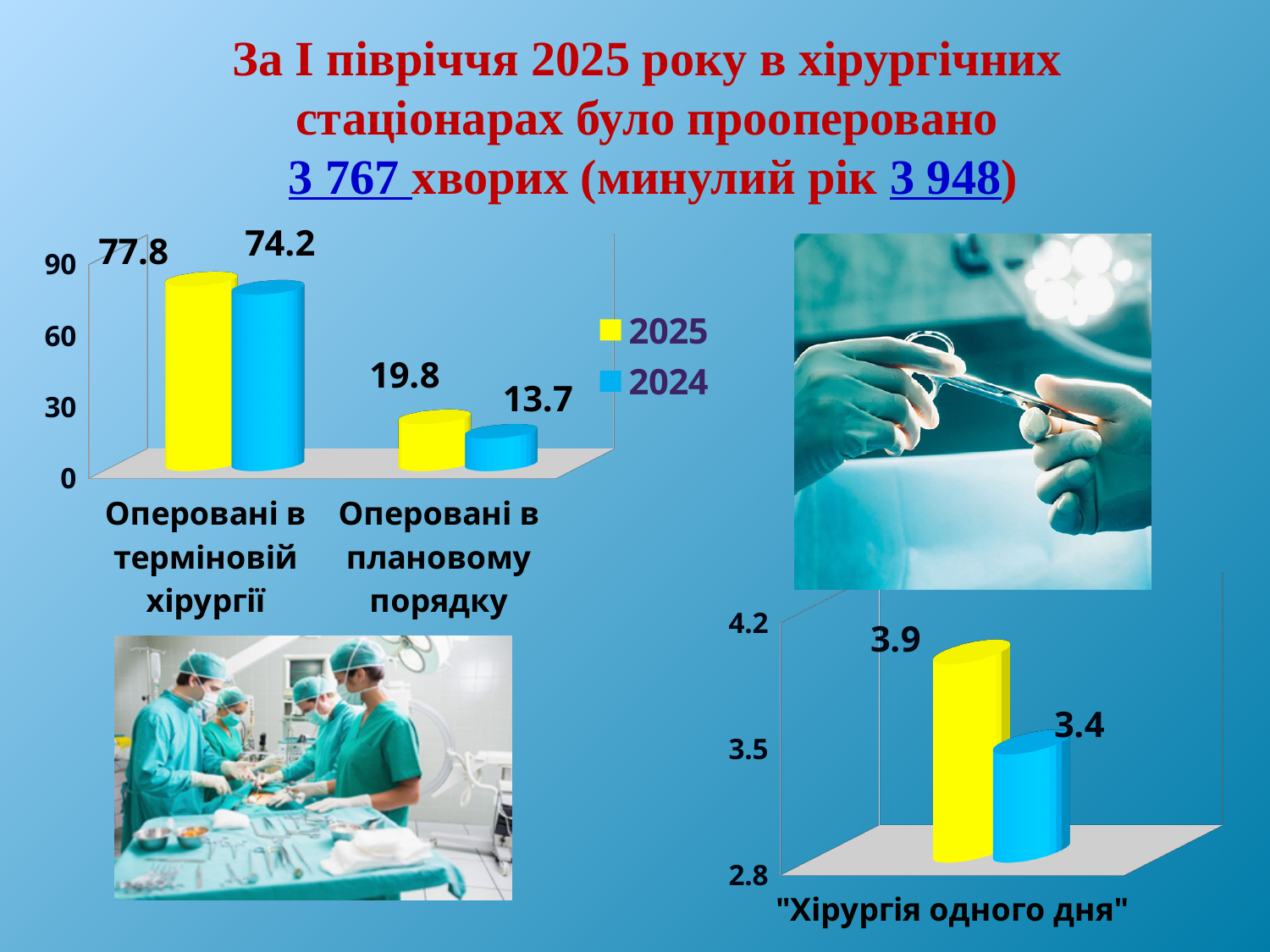
How many series does the legend of the left chart list? 2 In the left chart, what is the difference between the 2025 and 2024 values for 'Оперовані в плановому порядку'? 6.1 In the left chart, what is the 2024 value for 'Оперовані в плановому порядку'? 13.7 In the left chart, which category has the highest 2025 value? Оперовані в терміновій хірургії In the left chart, what is the 2025 value for 'Оперовані в терміновій хірургії'? 77.8 In the chart titled '"Хірургія одного дня"', what is the value of the yellow (2025) bar? 3.9 How many categories are shown on the x axis of the left chart? 2 In the left chart, is the 2025 value for 'Оперовані в плановому порядку' greater or less than 30? less In the left chart, what is the 2024 value for 'Оперовані в терміновій хірургії'? 74.2 What kind of chart is the left chart? bar chart In the left chart, which colour represents the 2024 series? blue In the chart titled '"Хірургія одного дня"', what is the difference between the yellow (2025) bar and the blue (2024) bar? 0.5